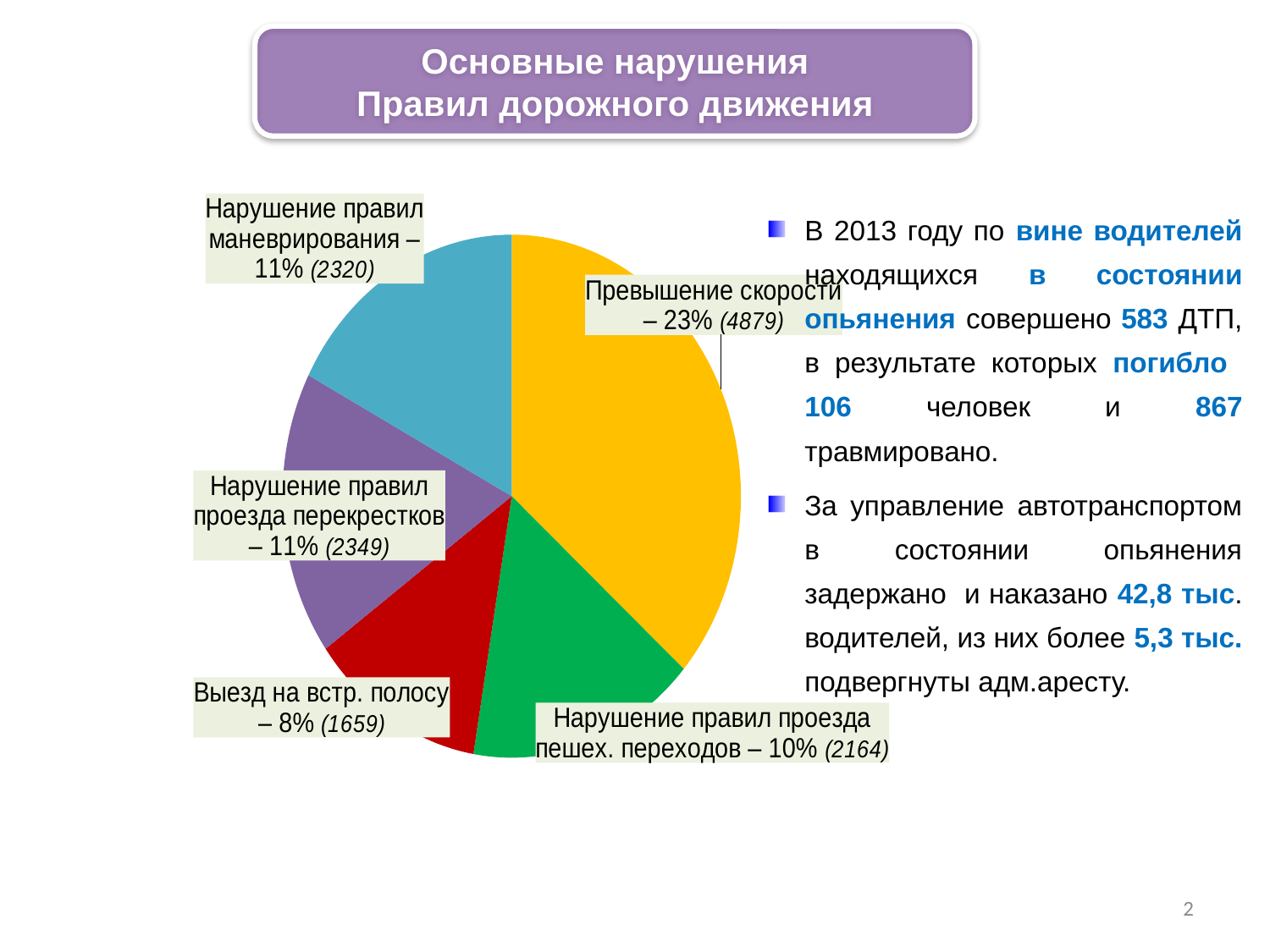
Which is larger: the count for "Нарушение правил проезда перекрестков" or for "Нарушение правил маневрирования"? Нарушение правил проезда перекрестков What percentage is shown for "Превышение скорости"? 23% What is the difference between the counts for "Превышение скорости" and "Выезд на встр. полосу"? 3220 What is the title of the slide containing the pie chart? Основные нарушения Правил дорожного движения Which category has the largest share of the pie? Превышение скорости What percentage is shown for "Выезд на встр. полосу"? 8% How many slices does the pie chart have? 5 What count is shown in parentheses for "Нарушение правил маневрирования"? 2320 What count is shown in parentheses for "Превышение скорости"? 4879 Which category has the smallest share of the pie? Выезд на встр. полосу What kind of chart is shown on the slide? pie chart What count is shown in parentheses for "Нарушение правил проезда пешех. переходов"? 2164